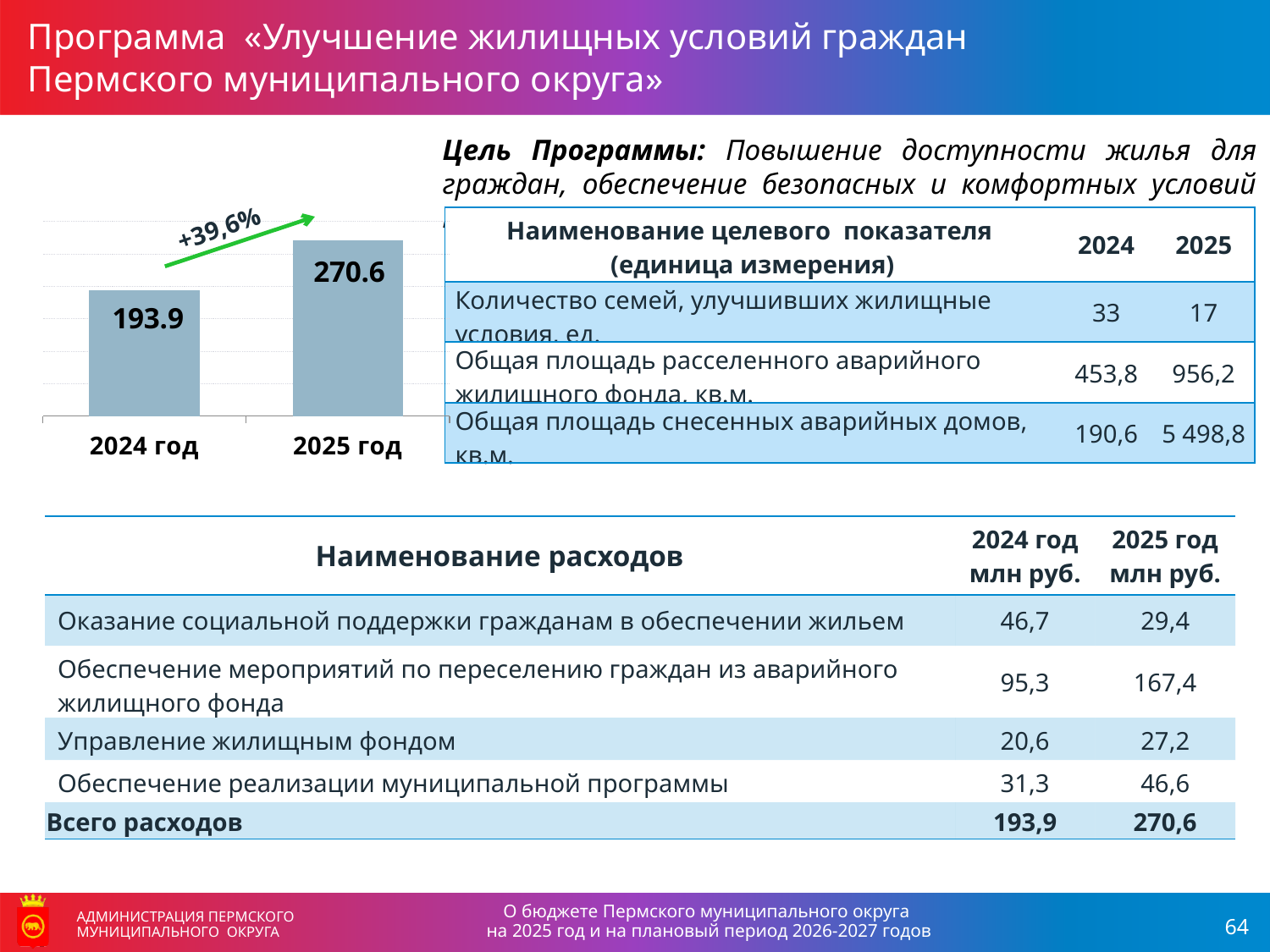
What is the value shown for the bar labelled 2024 год? 193.9 Which bar is the lowest in the chart? 2024 год Do the values rise or fall from 2024 год to 2025 год? rise Which bar is the highest in the chart? 2025 год What is the difference between the values for 2025 год and 2024 год? 76.7 What kind of chart is shown on the slide? bar chart Which is larger, the value for 2024 год or the value for 2025 год? 2025 год What percentage change is annotated above the bars in the chart? +39,6% What is the value shown for the bar labelled 2025 год? 270.6 What colour is the arrow annotation above the bars in the chart? green How many bars are plotted in the chart? 2